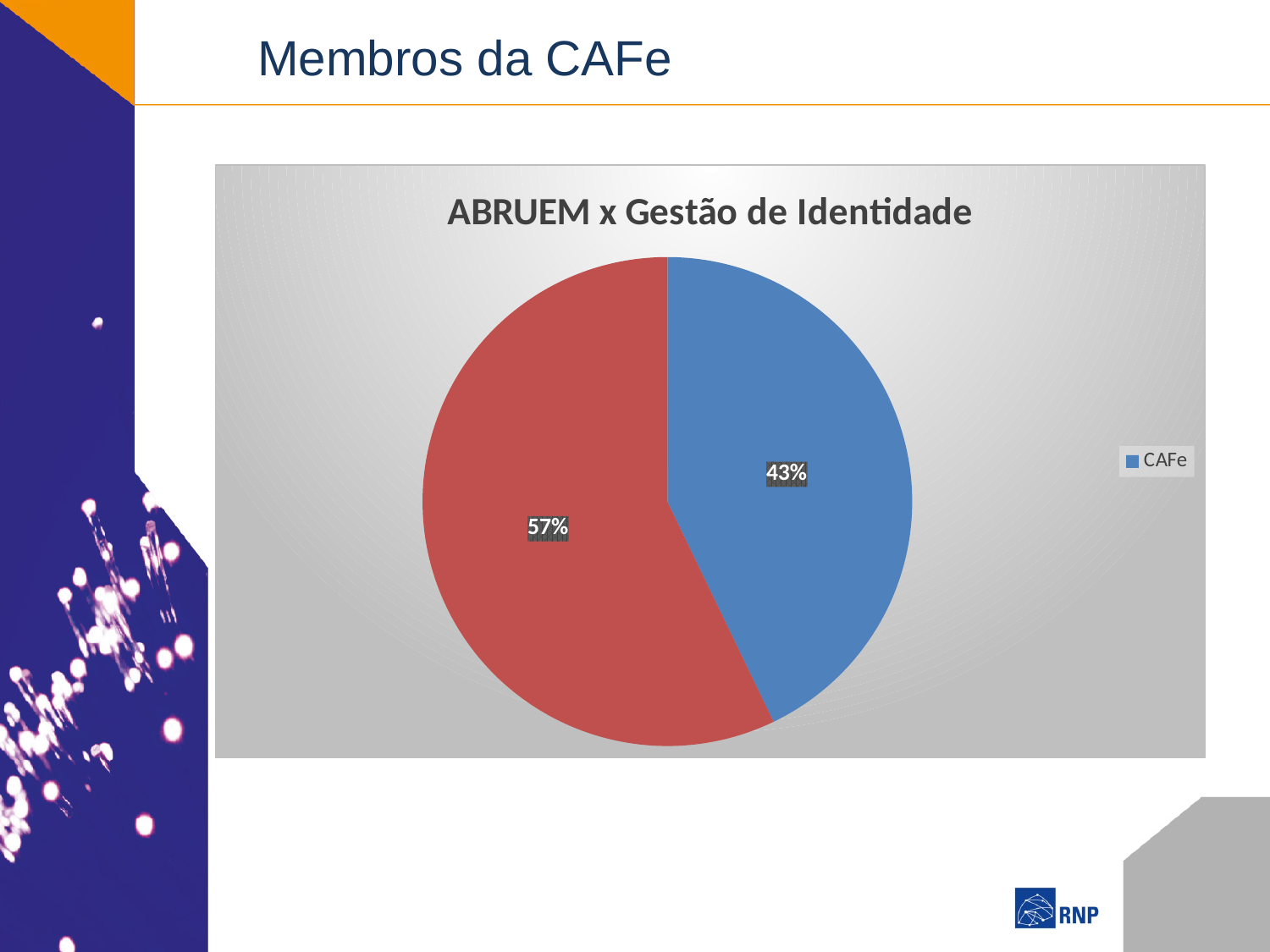
Which slice is larger, the blue CAFe slice or the red slice? the red slice How many entries does the legend list? 1 What kind of chart is shown on the slide? pie chart What is the title of the chart? ABRUEM x Gestão de Identidade What percentage is shown on the red slice of the pie? 57% What is the difference in percentage points between the red slice and the CAFe slice? 14 What percentage is shown on the blue slice of the pie? 43% How many slices does the pie chart have? 2 Which slice of the pie is the smallest? CAFe (43%) Is the share of the CAFe slice greater or less than 50%? less What share of the pie does the CAFe slice represent? 43% What colour is the CAFe slice in the pie chart? blue